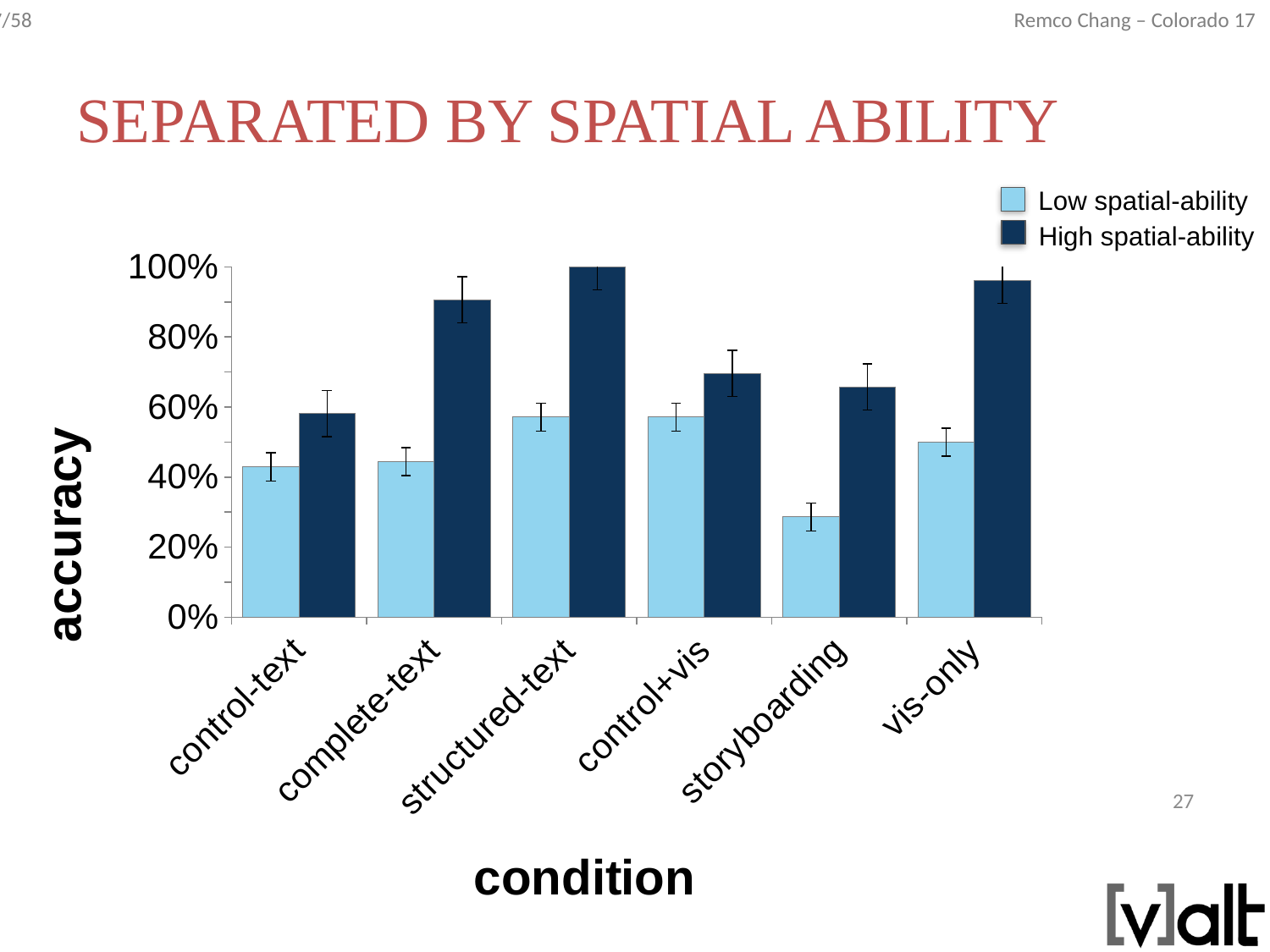
How many series does the legend list? 2 Which condition has the lowest accuracy for the Low spatial-ability series? storyboarding What is the label on the y axis? accuracy For the control-text condition, which series has the higher accuracy, Low spatial-ability or High spatial-ability? High spatial-ability Is the High spatial-ability accuracy for complete-text greater or less than 80%? greater What kind of chart is shown on the slide? bar chart How many conditions are shown on the x axis? 6 Is the Low spatial-ability accuracy for control-text greater or less than 60%? less Is the Low spatial-ability accuracy for storyboarding greater or less than 40%? less Which condition has the highest accuracy for the High spatial-ability series? structured-text For the High spatial-ability series, which condition has the higher accuracy, vis-only or control+vis? vis-only What are the two series named in the legend? Low spatial-ability and High spatial-ability